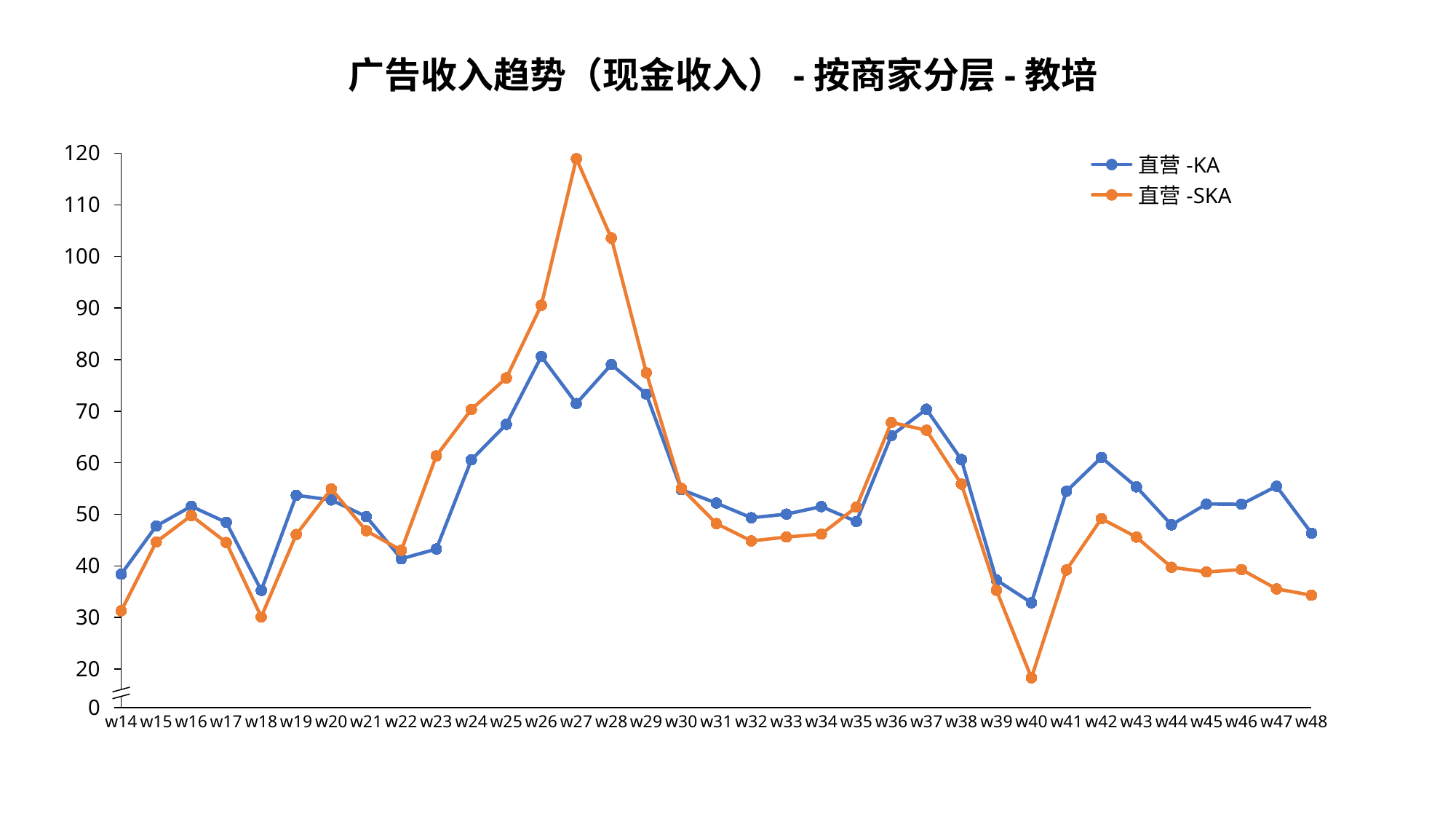
Is the value for 直营-SKA at w28 greater or less than 100? greater In which week does the 直营-SKA series reach its lowest value? w40 Does the 直营-SKA series rise or fall from w27 to w30? fall Which series has the larger value at w27, 直营-KA or 直营-SKA? 直营-SKA How many series does the legend list? 2 How many weeks are plotted along the x axis? 35 Which series has the larger value at w48, 直营-KA or 直营-SKA? 直营-KA In which week does the 直营-SKA series reach its highest value? w27 What is the title of the chart? 广告收入趋势（现金收入） - 按商家分层 - 教培 What kind of chart is shown on the slide? line chart Is the value for 直营-SKA at w27 greater or less than 110? greater Is the value for 直营-KA at w40 greater or less than 40? less